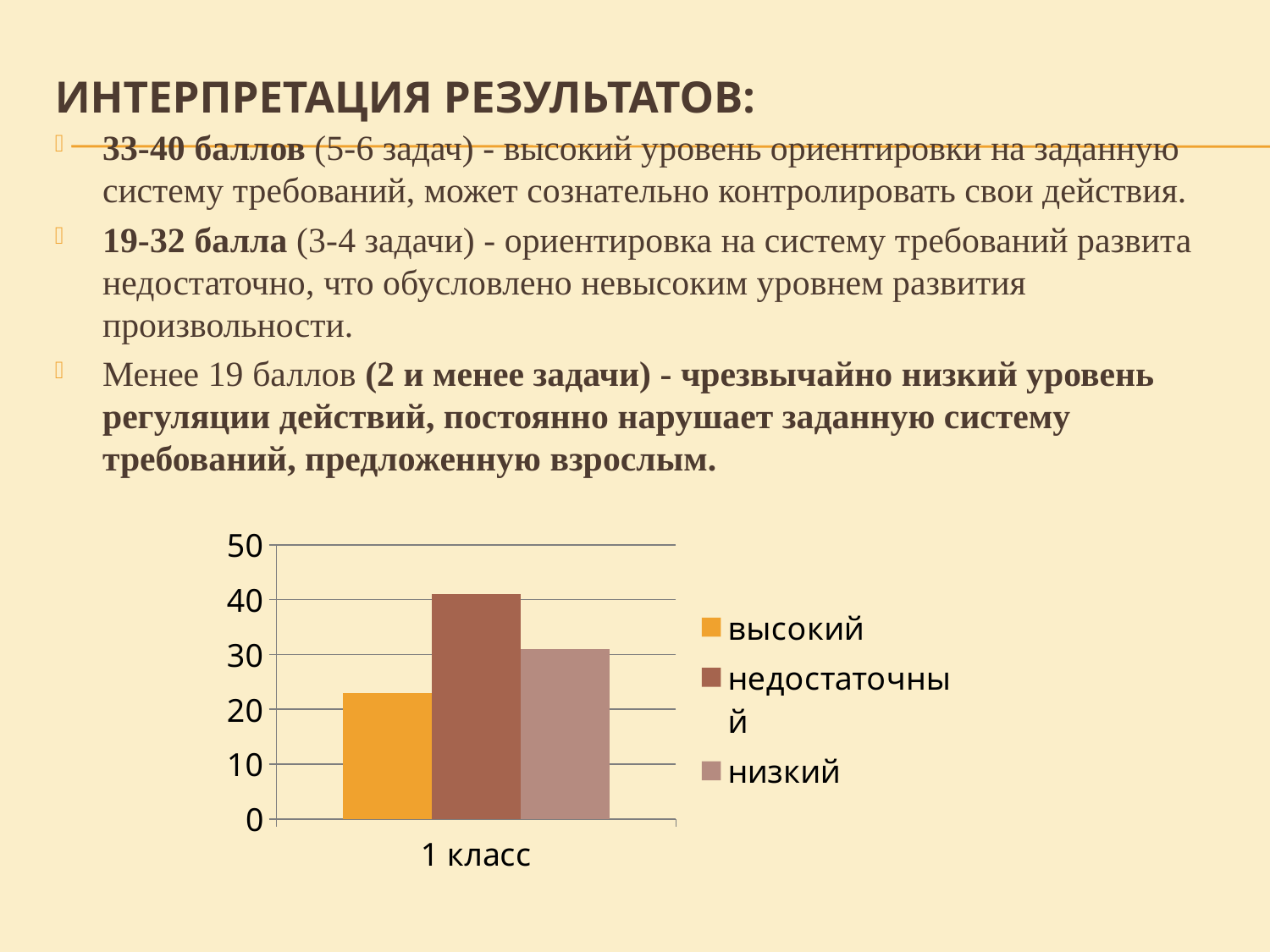
Is the value for высокий greater or less than 30? less Which is larger in the chart: the bar for недостаточный or the bar for низкий? недостаточный Is the value for высокий greater or less than 20? greater What kind of chart is shown on the slide? bar chart Which is larger in the chart: the bar for высокий or the bar for низкий? низкий Which series has the lowest bar in the chart? высокий Which series has the highest bar in the chart? недостаточный What is the category label on the x axis of the chart? 1 класс How many categories are shown on the x axis of the chart? 1 Is the value for низкий greater or less than 40? less How many series does the chart legend list? 3 Which series is shown in orange in the chart legend? высокий